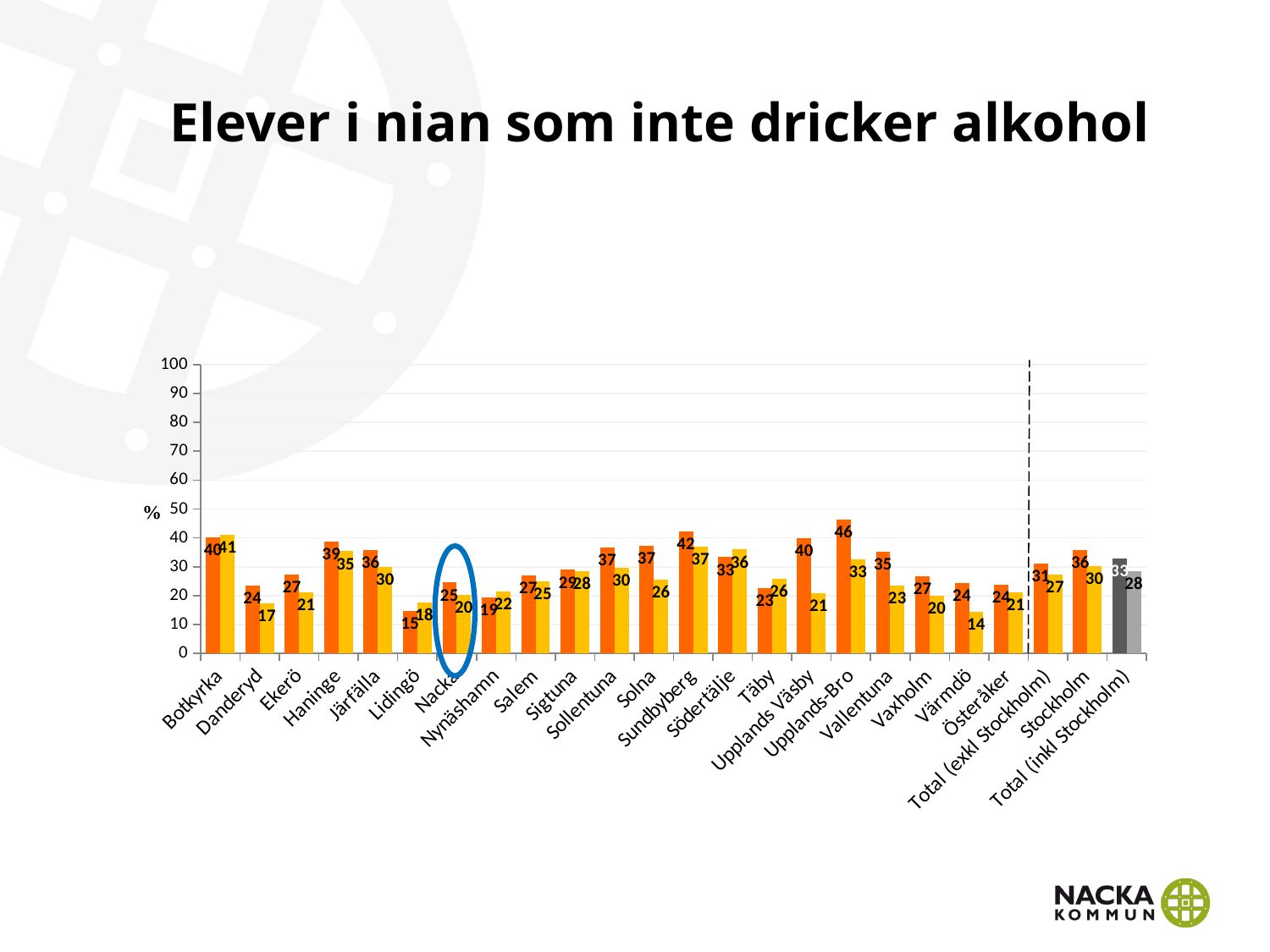
What is the value of the yellow (right) bar for Värmdö? 14 What is the value of the orange (left) bar for Stockholm? 36 What kind of chart is shown on the slide? bar chart What is the difference between the orange and yellow bars for Upplands Väsby? 19 What is the value of the orange (left) bar for Upplands-Bro? 46 What is the title of the chart on the slide? Elever i nian som inte dricker alkohol Is the orange (left) bar for Sundbyberg greater or less than 40? greater What is the value of the yellow (right) bar for Nacka? 20 How many categories are shown on the x axis? 24 Which is larger for Lidingö, the orange (left) bar or the yellow (right) bar? the yellow (right) bar Which municipality has the lowest yellow (right) bar? Värmdö Which municipality has the highest orange (left) bar? Upplands-Bro